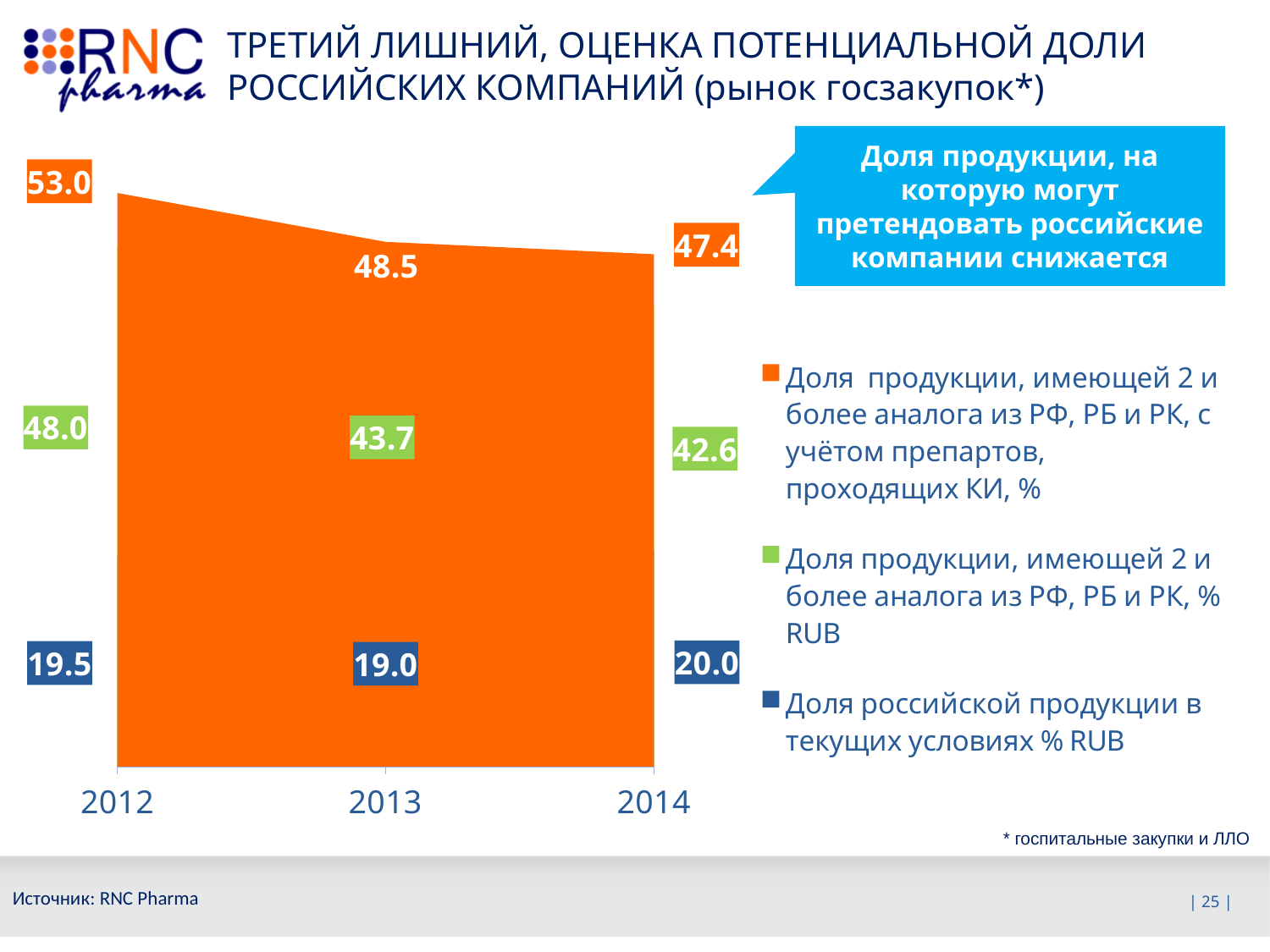
What kind of chart is shown on the slide? Area chart How many series does the legend list? 3 What is the value of the green series (share of products with 2 or more analogues from RF, RB and RK, % RUB) in 2014? 42.6 What is the difference between the green series and the blue series in 2013? 24.7 Does the green series rise or fall from 2012 to 2014? Fall What is the value of the blue series (share of Russian products under current conditions, % RUB) in 2013? 19.0 How many years are shown on the x axis? 3 What is the value of the orange series (share of products with 2 or more analogues from RF, RB and RK, including drugs in clinical trials, %) in 2012? 53.0 In which year is the orange series at its highest? 2012 Which is larger in 2014: the orange series value or the green series value? The orange series (47.4) By how much did the orange series fall from 2012 to 2014? 5.6 In which year is the blue series at its lowest? 2013